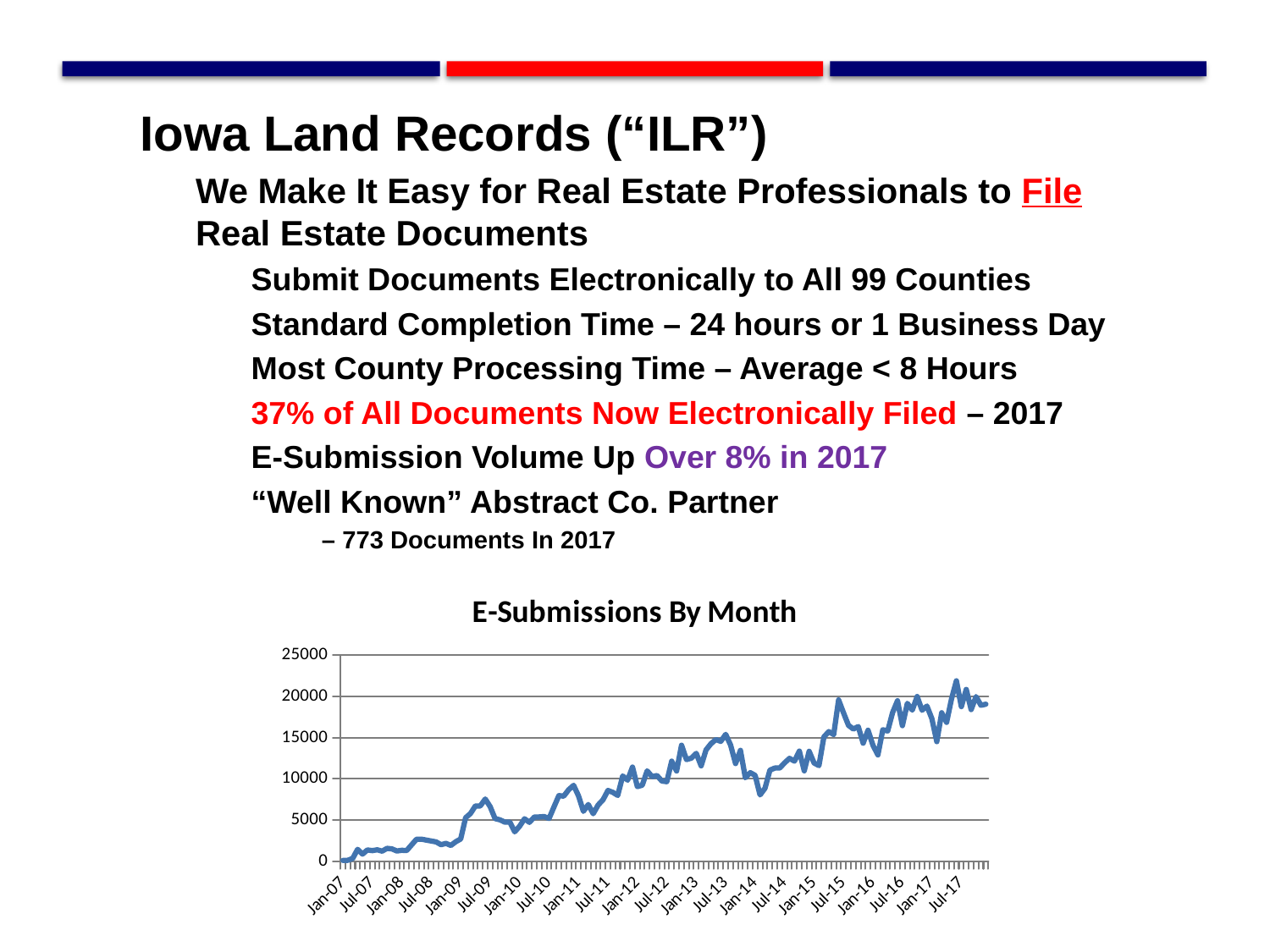
Overall, do e-submissions rise or fall from Jan-07 to Jul-17 in the "E-Submissions By Month" chart? rise What is the highest value shown on the y-axis of the "E-Submissions By Month" chart? 25000 In the "E-Submissions By Month" chart, is the value for Jan-09 greater or less than 5000? less In the "E-Submissions By Month" chart, is the value for Jan-17 greater or less than 15000? greater What kind of chart is "E-Submissions By Month"? line chart In the "E-Submissions By Month" chart, is the value for Jul-11 greater or less than 10000? less What is the title of the chart on the slide? E-Submissions By Month In the "E-Submissions By Month" chart, which is larger, the value for Jan-07 or the value for Jul-17? Jul-17 In the "E-Submissions By Month" chart, which is larger, the value for Jan-14 or the value for Jul-15? Jul-15